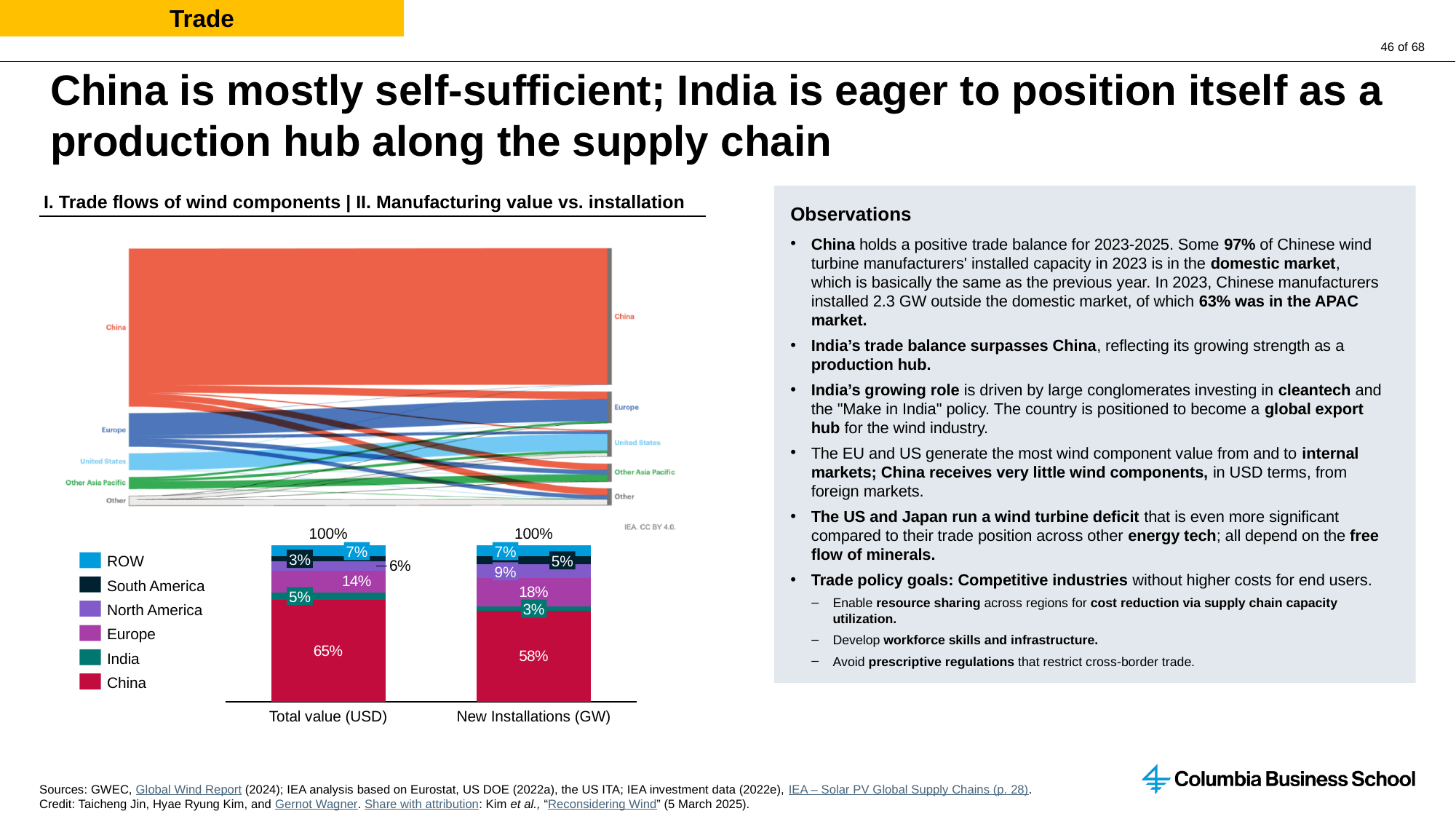
In the stacked bar chart at the bottom left, what is China's share of Total value (USD)? 65% How many bars are shown in the stacked bar chart at the bottom left? 2 In the stacked bar chart at the bottom left, what is China's share of New Installations (GW)? 58% What kind of chart is the upper chart showing trade flows of wind components? Sankey diagram In the stacked bar chart at the bottom left, what is the difference between China's share of Total value (USD) and its share of New Installations (GW)? 7 percentage points In the stacked bar chart at the bottom left, is Europe's share larger for Total value (USD) or for New Installations (GW)? New Installations (GW) How many series does the legend of the stacked bar chart at the bottom left list? 6 In the stacked bar chart at the bottom left, what is Europe's share of New Installations (GW)? 18% In the stacked bar chart at the bottom left, which region has the smallest share of New Installations (GW)? India In the stacked bar chart at the bottom left, what is the total of the Total value (USD) bar? 100% In the stacked bar chart at the bottom left, which region has the largest share of Total value (USD)? China In the stacked bar chart at the bottom left, what is India's share of Total value (USD)? 5%